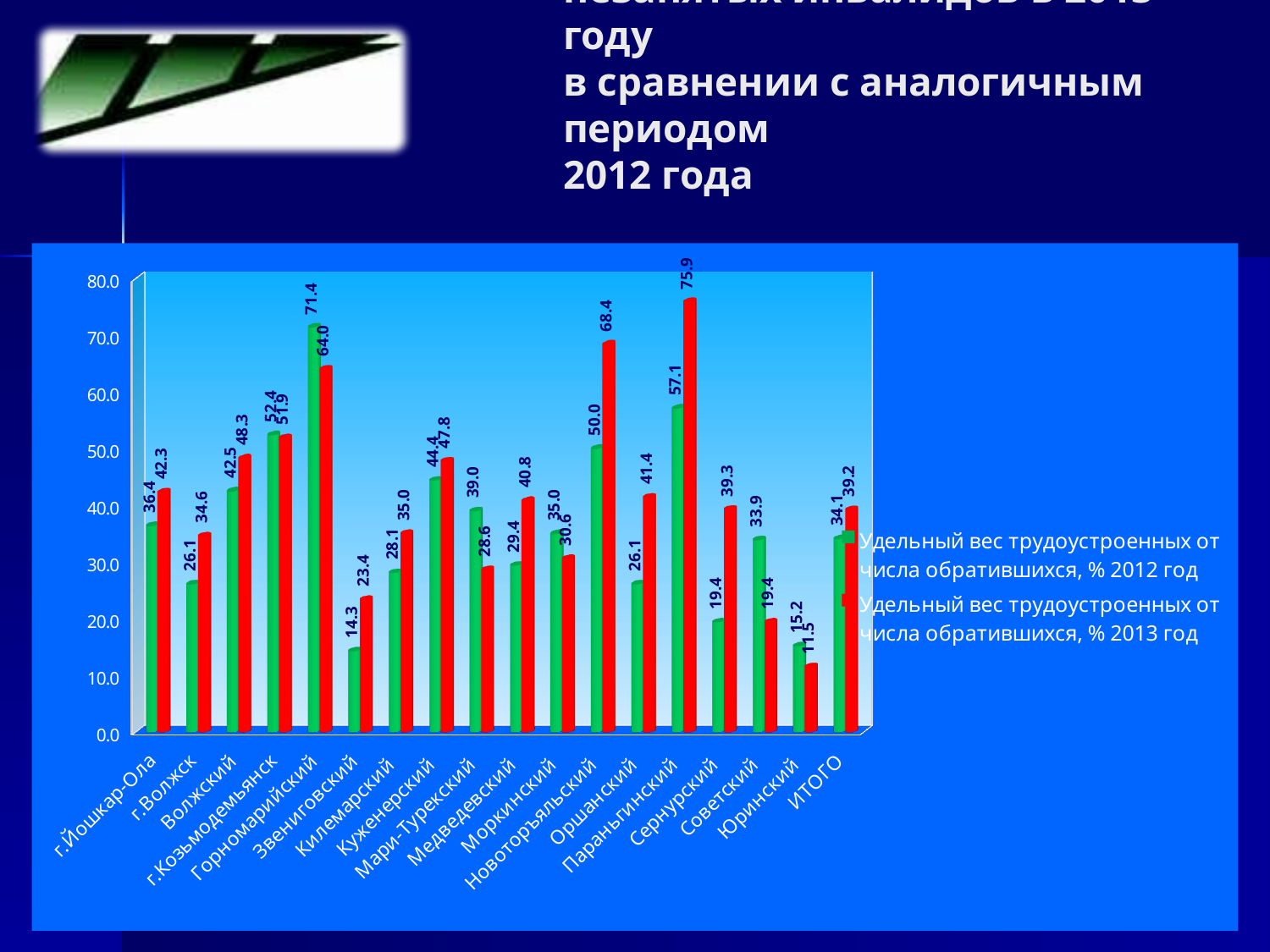
What is the 2013 value for ИТОГО? 39.2 What kind of chart is shown on the slide? Bar chart Which category has the lowest 2012 value? Звениговский For Советский, which is larger: the 2012 value or the 2013 value? 2012 value How many series does the legend list? 2 What is the difference between the 2013 and 2012 values for Новоторъяльский? 18.4 Which category has the highest 2013 value? Параньгинский How many categories are shown on the x axis? 18 For Сернурский, which is larger: the 2012 value or the 2013 value? 2013 value What is the 2013 value (Удельный вес трудоустроенных от числа обратившихся, % 2013 год) for Параньгинский? 75.9 What is the 2012 value (Удельный вес трудоустроенных от числа обратившихся, % 2012 год) for Горномарийский? 71.4 Which category has the lowest 2013 value? Юринский